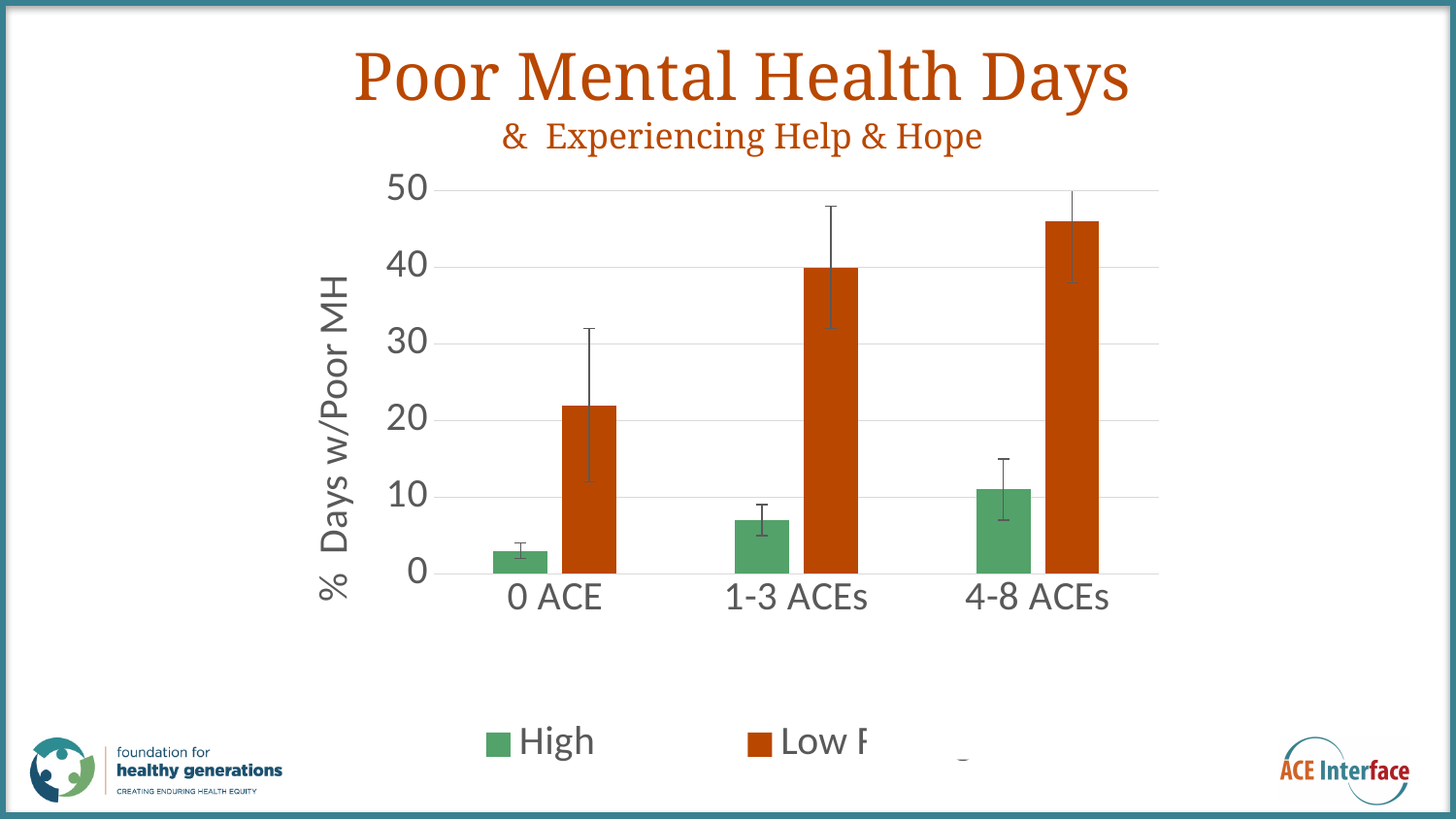
Which ACE category has the tallest orange (Low) bar? 4-8 ACEs Is the value of the green (High) bar for 1-3 ACEs greater or less than 10? less What kind of chart is shown on the slide? bar chart Which ACE category has the shortest green (High) bar? 0 ACE How many series does the legend list? 2 How many ACE categories are shown on the x axis? 3 Do the green (High) bars rise or fall as the number of ACEs increases along the x axis? rise What is the label on the y axis of the chart? % Days w/Poor MH For 1-3 ACEs, which series has the larger value, High or Low? Low Is the value of the orange (Low) bar for 0 ACE greater or less than 30? less Is the value of the green (High) bar for 4-8 ACEs greater or less than 20? less